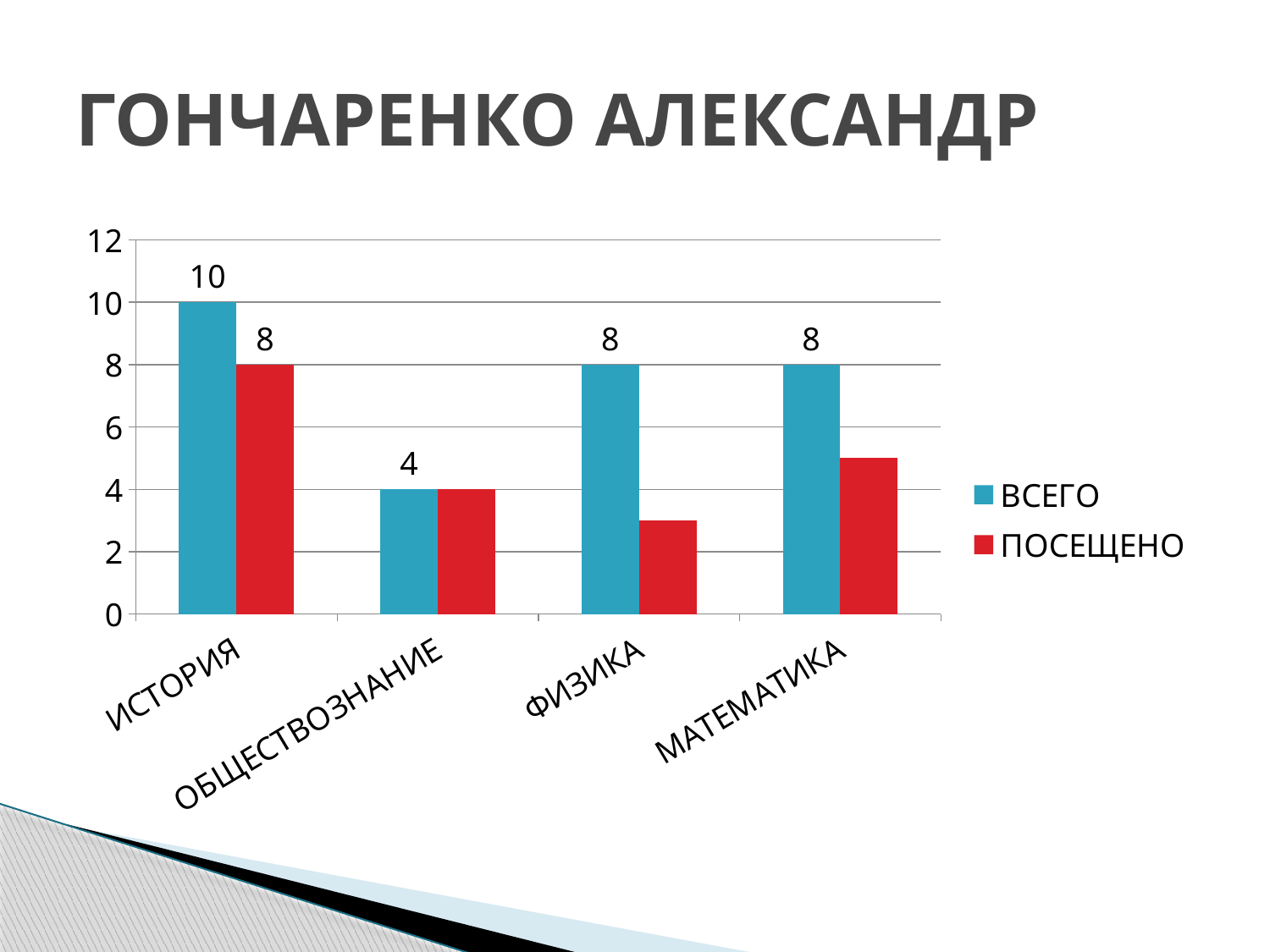
Is the ПОСЕЩЕНО value for МАТЕМАТИКА greater or less than 4? greater What is the ВСЕГО value for ФИЗИКА? 8 How many series does the legend list? 2 What is the ВСЕГО value for ОБЩЕСТВОЗНАНИЕ? 4 What is the ВСЕГО value for ИСТОРИЯ? 10 What is the difference between the ВСЕГО and ПОСЕЩЕНО values for ИСТОРИЯ? 2 How many categories are shown on the x axis? 4 Which is larger: the ВСЕГО value for ФИЗИКА or the ВСЕГО value for ОБЩЕСТВОЗНАНИЕ? ФИЗИКА Which category has the highest ВСЕГО value? ИСТОРИЯ What is the ПОСЕЩЕНО value for ИСТОРИЯ? 8 Is the ПОСЕЩЕНО value for ФИЗИКА greater or less than 4? less Which category has the lowest ВСЕГО value? ОБЩЕСТВОЗНАНИЕ